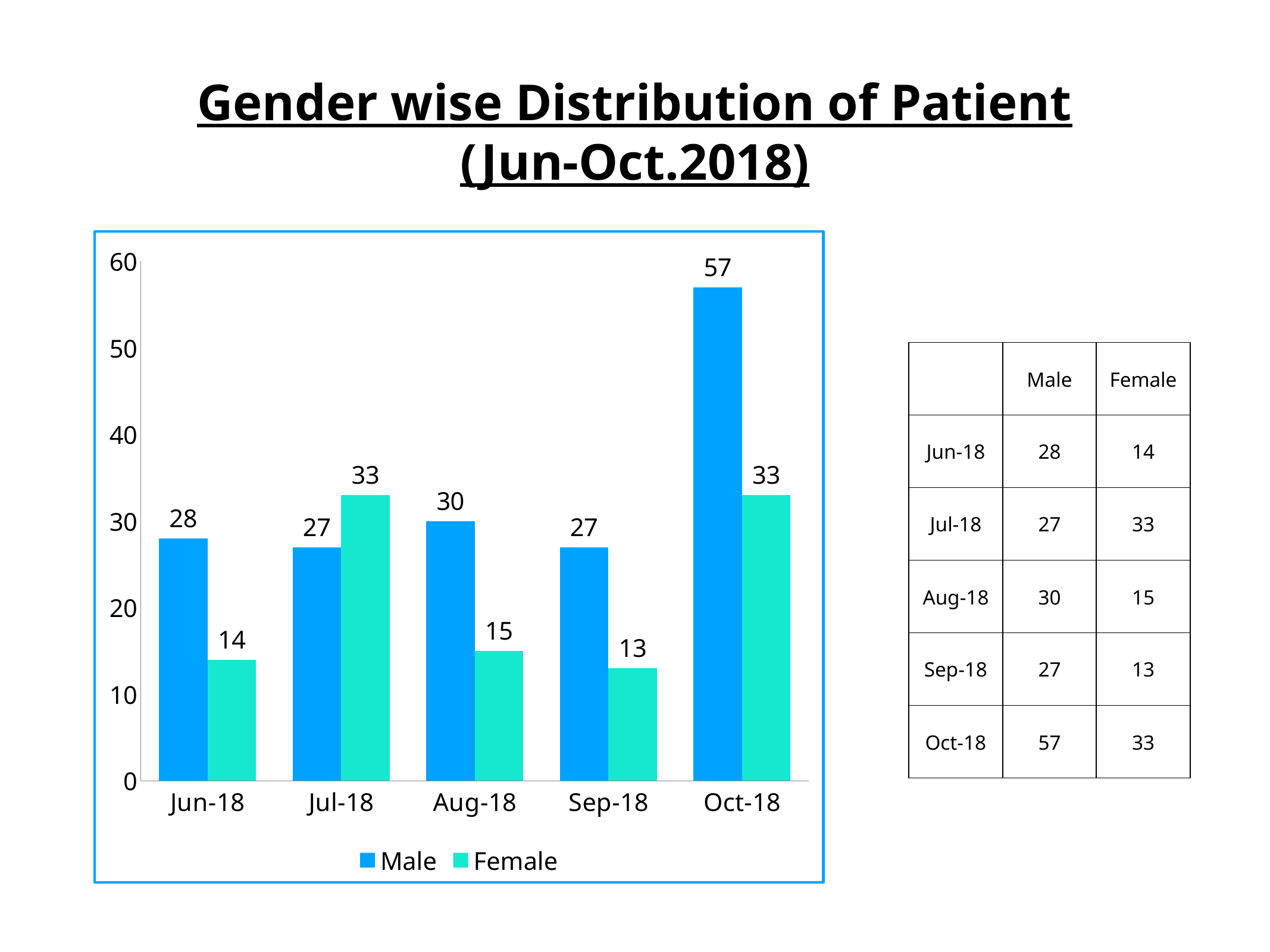
What is the Female value for Sep-18? 13 Which month has the lowest Female value? Sep-18 Which is larger for Jul-18, the Male value or the Female value? Female What is the Male value for Oct-18? 57 What is the difference between the Male and Female values for Oct-18? 24 Is the Male value for Oct-18 greater or less than 50? greater How many series does the legend list? 2 What is the title of the slide? Gender wise Distribution of Patient (Jun-Oct.2018) What is the Female value for Jul-18? 33 Which month has the highest Male value? Oct-18 How many months are shown on the x axis? 5 What kind of chart is shown on the slide? Bar chart